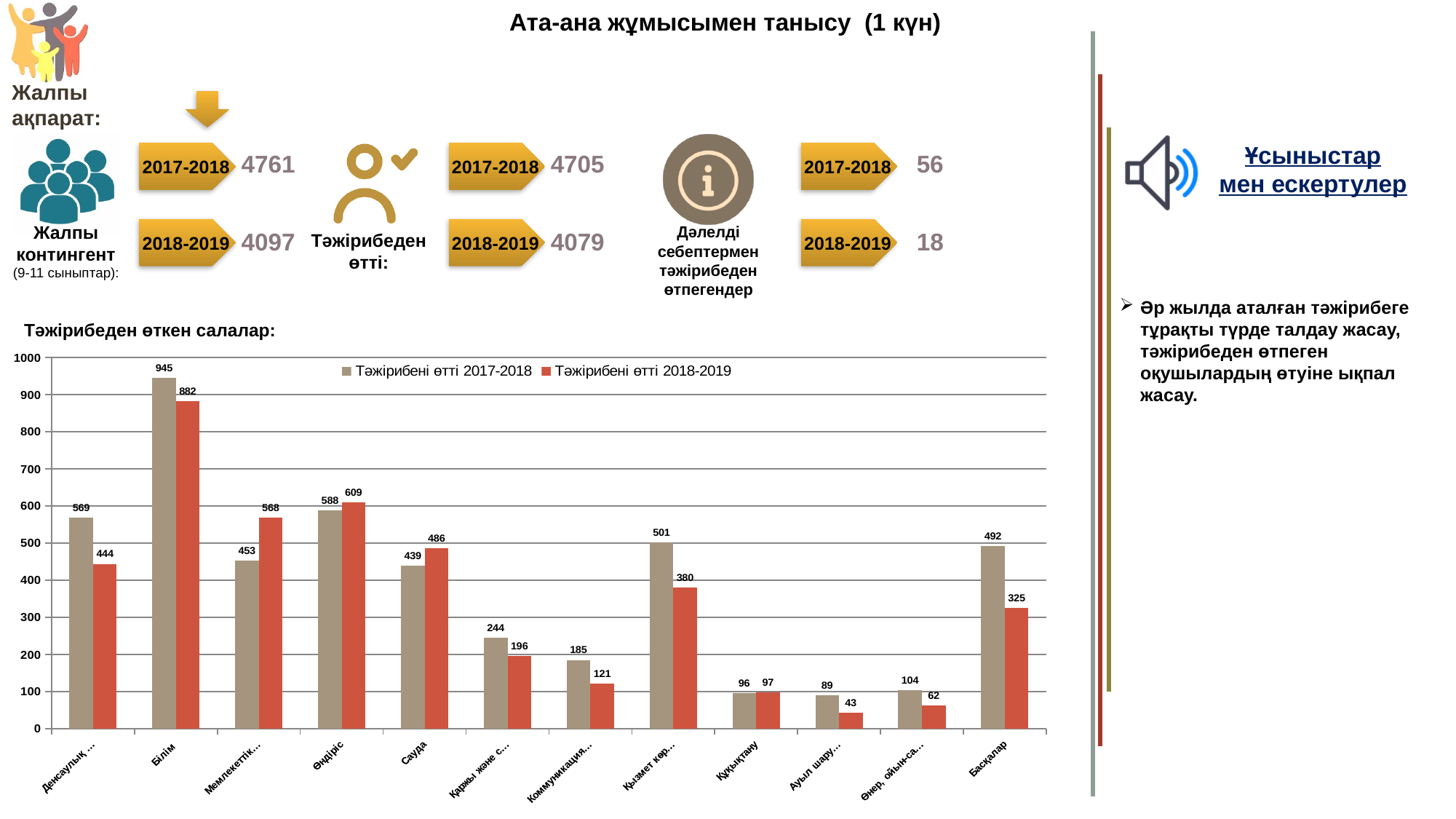
What is the value for Өндіріс in the series "Тәжірибені өтті 2018-2019"? 609 Which category has the lowest value in the series "Тәжірибені өтті 2018-2019"? Ауыл шару... What type of chart is shown under the heading "Тәжірибеден өткен салалар"? bar chart What is the difference between the 2017-2018 and 2018-2019 values for Білім? 63 How many categories are shown on the x axis of the chart? 12 For Сауда, which series has the larger value: "Тәжірибені өтті 2017-2018" or "Тәжірибені өтті 2018-2019"? Тәжірибені өтті 2018-2019 How many series does the chart legend list? 2 What is the value for Құқықтану in the series "Тәжірибені өтті 2017-2018"? 96 What is the value for Білім in the series "Тәжірибені өтті 2017-2018"? 945 What colour are the bars for the series "Тәжірибені өтті 2018-2019"? red What is the value for Басқалар in the series "Тәжірибені өтті 2018-2019"? 325 Which category has the highest value in the series "Тәжірибені өтті 2017-2018"? Білім